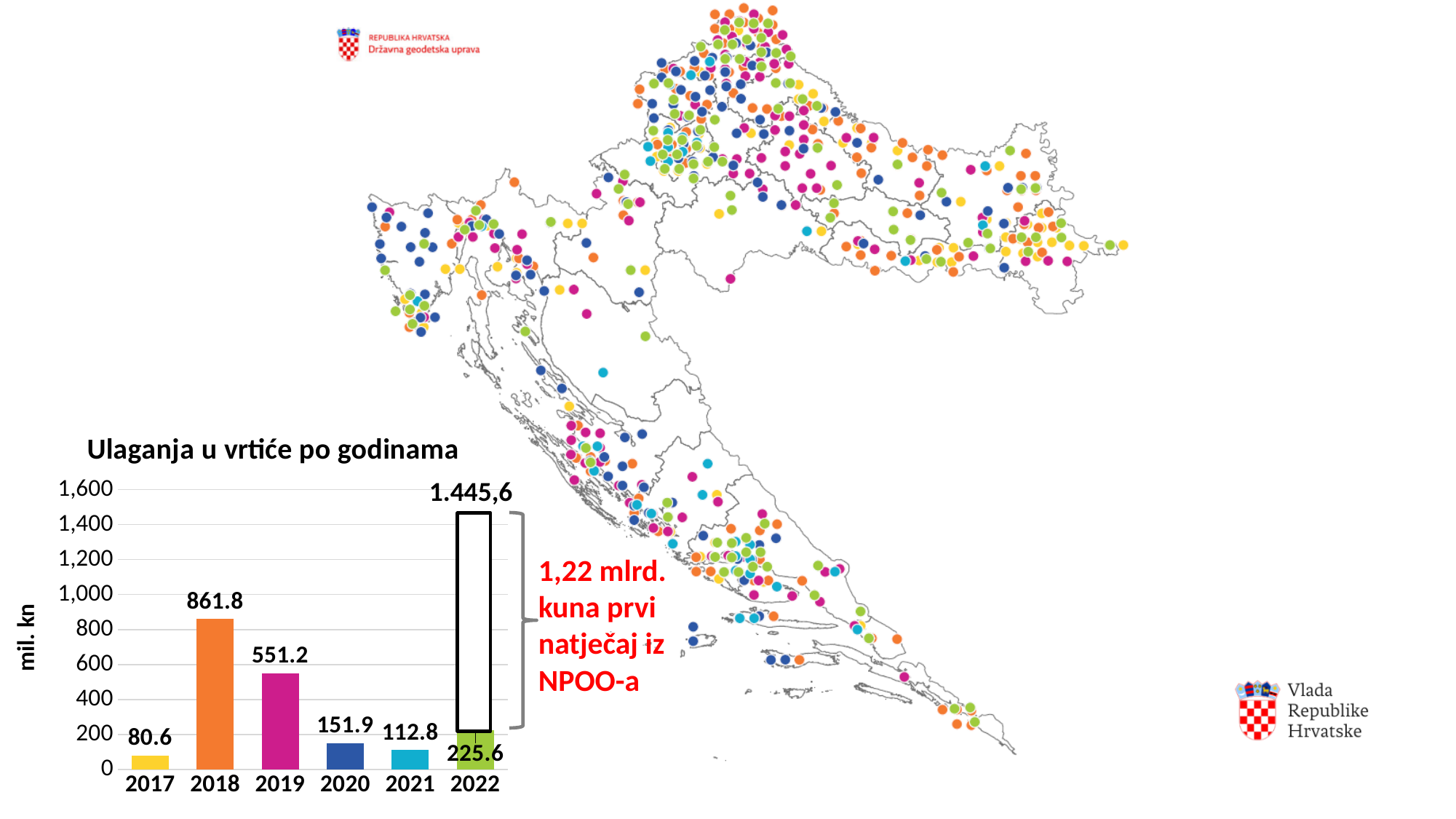
How many years are shown on the x axis of the chart 'Ulaganja u vrtiće po godinama'? 6 What type of chart is shown in the lower left of the slide? bar chart In the chart 'Ulaganja u vrtiće po godinama', do the values rise or fall from 2018 to 2021? fall What is the title of the bar chart on the slide? Ulaganja u vrtiće po godinama What is the value labelled on the green bar for 2022 in the chart 'Ulaganja u vrtiće po godinama'? 225.6 What is the value for 2018 in the chart 'Ulaganja u vrtiće po godinama'? 861.8 What value is labelled at the top of the 2022 bar in the chart 'Ulaganja u vrtiće po godinama'? 1.445,6 Which year has the lowest value in the chart 'Ulaganja u vrtiće po godinama'? 2017 In the chart 'Ulaganja u vrtiće po godinama', what is the difference between the values for 2018 and 2019? 310.6 In the chart 'Ulaganja u vrtiće po godinama', what is the difference between the values for 2020 and 2021? 39.1 In the chart 'Ulaganja u vrtiće po godinama', which is larger, the value for 2019 or the value for 2020? 2019 What is the value for 2019 in the chart 'Ulaganja u vrtiće po godinama'? 551.2